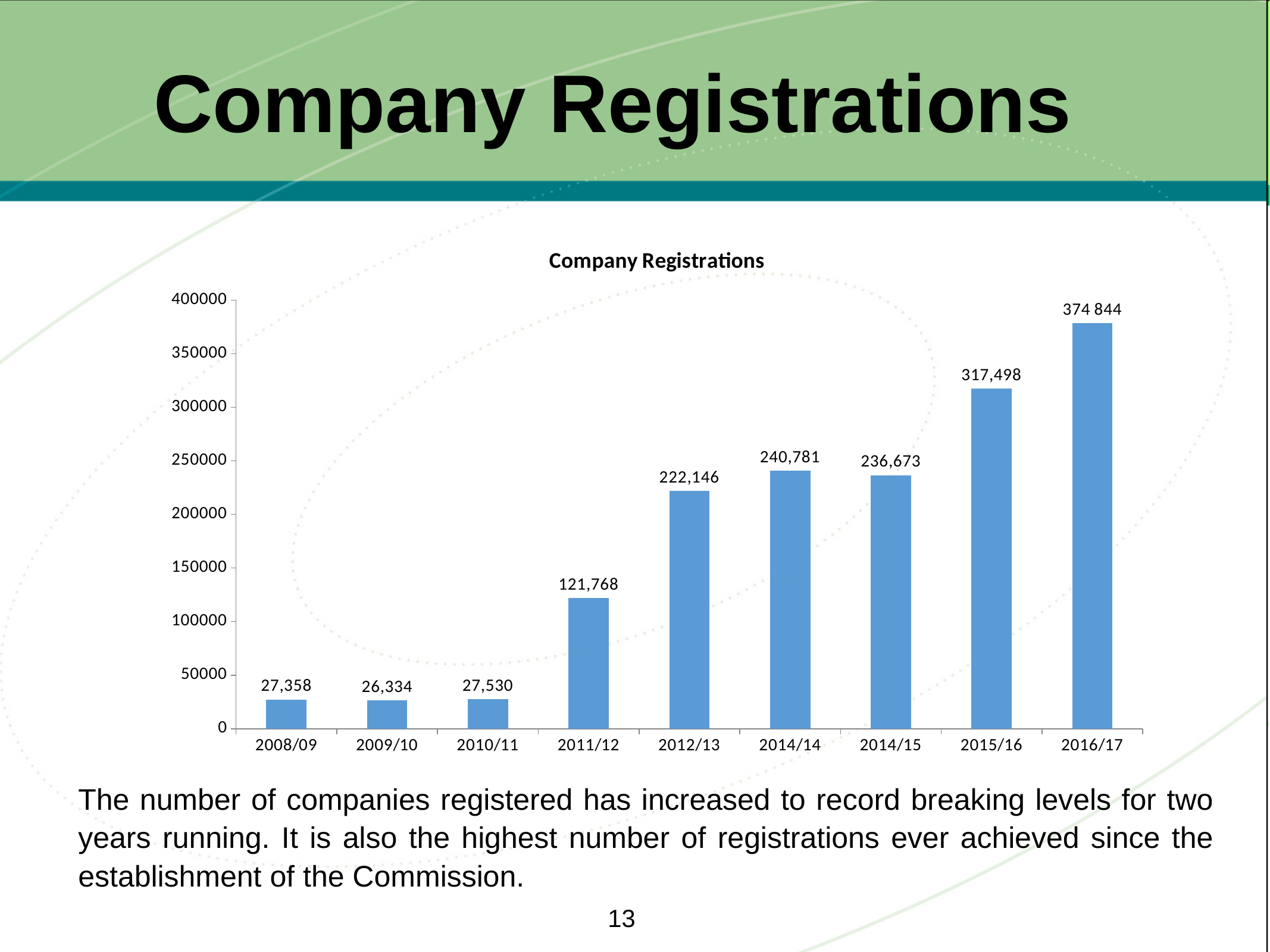
Which category has the highest value? 2016/17 Which is larger, the value for 2014/14 or the value for 2014/15? 2014/14 What is the title of the chart? Company Registrations What kind of chart is shown on the slide? bar chart How many categories are shown on the x axis? 9 What is the value for 2011/12? 121,768 Is the value for 2015/16 greater or less than 300000? greater What is the value for 2014/15? 236,673 Which category has the lowest value? 2009/10 What is the difference between the values for 2016/17 and 2015/16? 57,346 What is the value for 2016/17? 374 844 What is the difference between the values for 2012/13 and 2011/12? 100,378